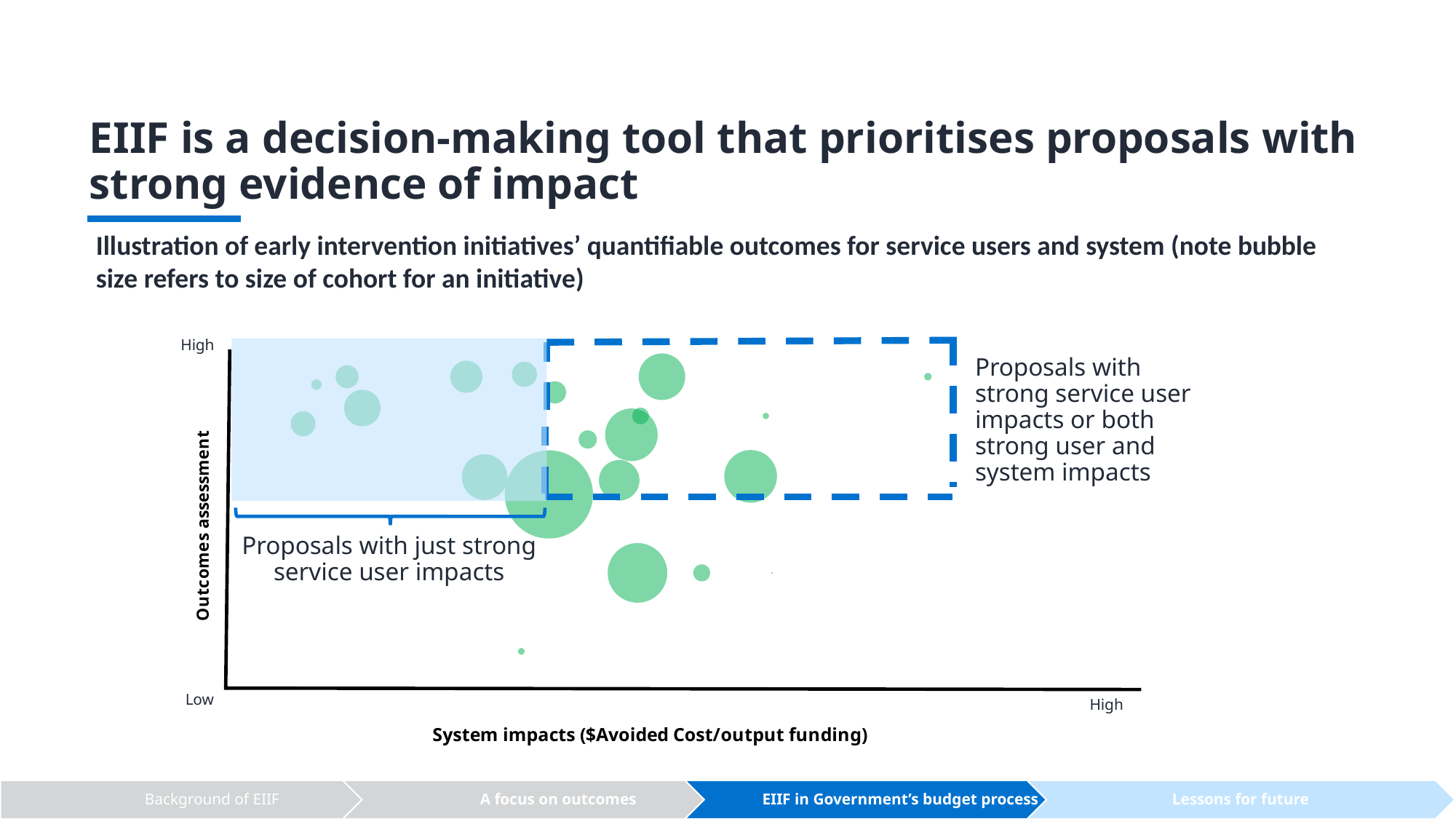
What are the two end labels shown on the y axis of the chart? Low and High According to the chart's subtitle, what does the bubble size refer to? Size of cohort for an initiative What kind of chart is shown on the slide? Bubble chart What is the label of the y axis of the chart? Outcomes assessment What is the label of the x axis of the chart? System impacts ($Avoided Cost/output funding)